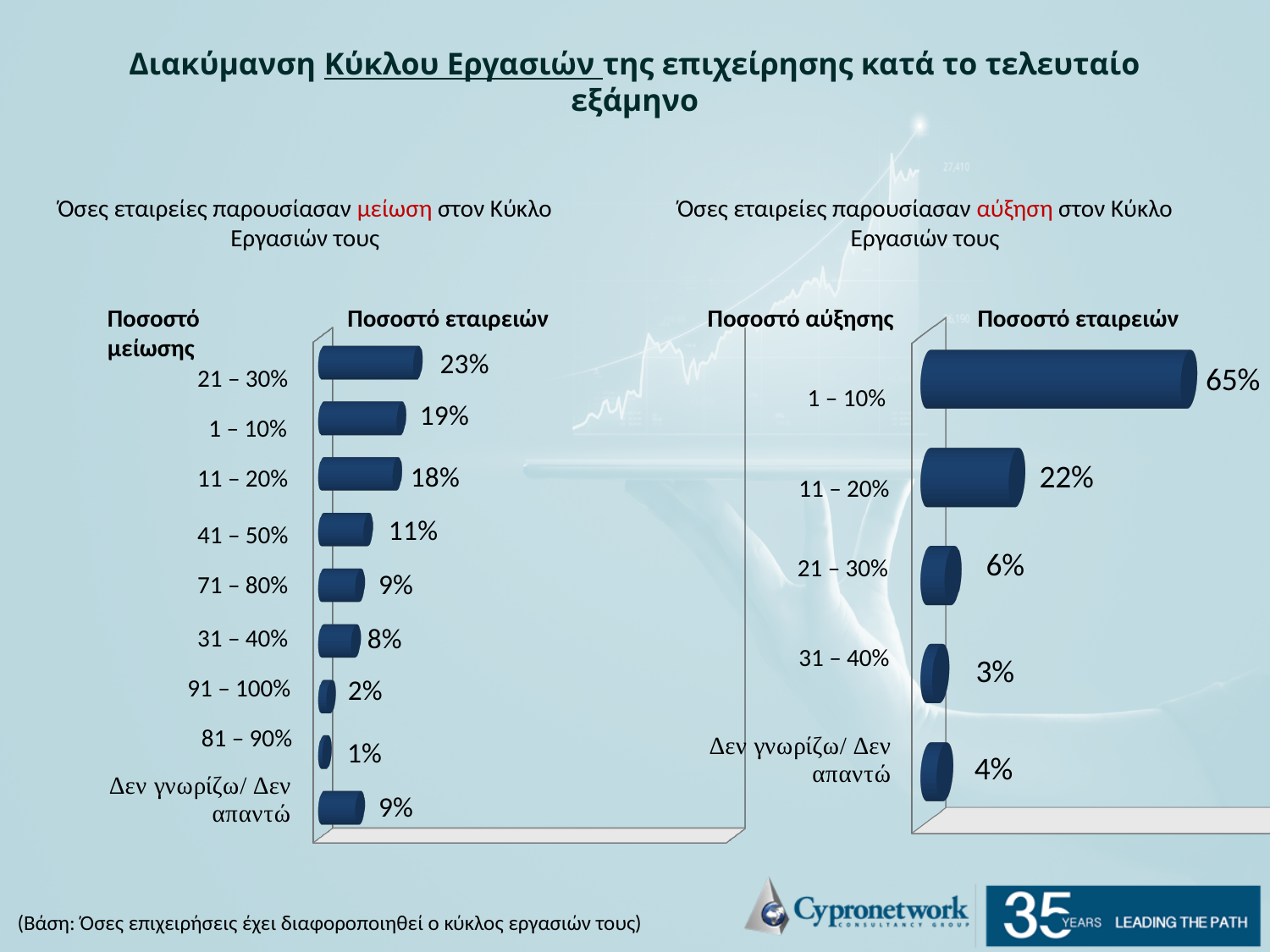
In the left chart (decrease in turnover), which is larger: the percentage for 71 – 80% or the percentage for 31 – 40%? 71 – 80% In the left chart (decrease in turnover), which decrease range has the highest percentage of companies? 21 – 30% In the right chart (companies with an increase in turnover), what percentage of companies reported an increase of 1 – 10%? 65% In the right chart (increase in turnover), what percentage of companies answered 'Δεν γνωρίζω/ Δεν απαντώ'? 4% In the left chart (decrease in turnover), what is the difference between the percentage for 1 – 10% and the percentage for 41 – 50%? 8% How many categories are shown in the left chart (decrease in turnover)? 9 In the right chart (increase in turnover), which increase range has the lowest percentage of companies? 31 – 40% How many categories are shown in the right chart (increase in turnover)? 5 In the left chart (companies with a decrease in turnover), what percentage of companies reported a decrease of 21 – 30%? 23% What type of chart is used on the right side of the slide (increase in turnover)? Bar chart In the left chart (decrease in turnover), which decrease range has the lowest percentage of companies? 81 – 90% In the right chart (increase in turnover), what is the difference between the percentage for 1 – 10% and the percentage for 11 – 20%? 43%